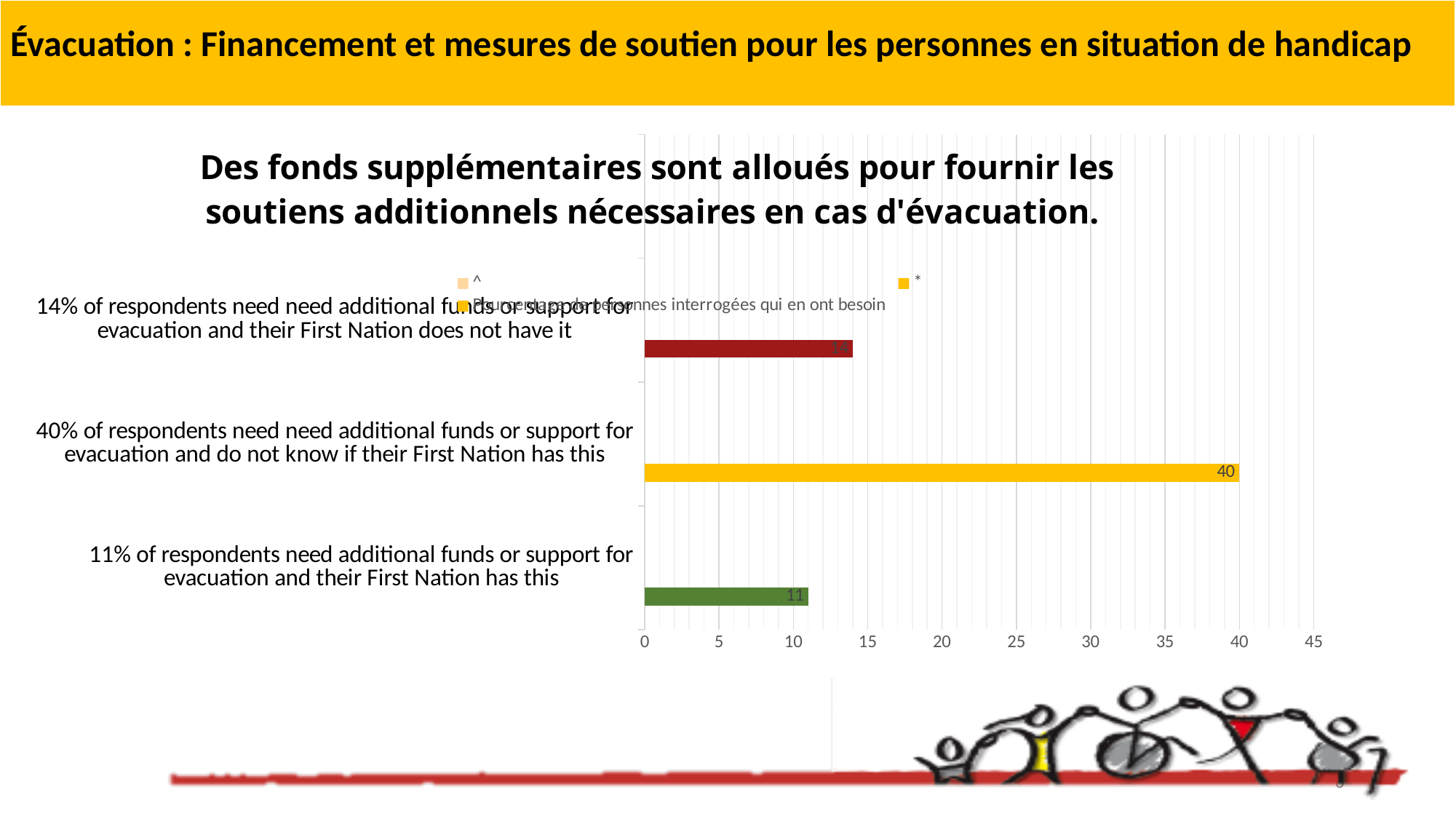
How many bars (categories) are plotted in the chart? 3 What is the difference between the value for respondents whose First Nation does not have it and the value for respondents whose First Nation has this? 3 Is the value for respondents who do not know if their First Nation has this greater or less than 35? greater Which category has the highest value? 40% of respondents need need additional funds or support for evacuation and do not know if their First Nation has this What is the value for the category '11% of respondents need additional funds or support for evacuation and their First Nation has this'? 11 What type of chart is shown on the slide? bar chart What is the title of the chart? Des fonds supplémentaires sont alloués pour fournir les soutiens additionnels nécessaires en cas d'évacuation. What is the value for the category '40% of respondents need need additional funds or support for evacuation and do not know if their First Nation has this'? 40 Which is larger: the value for respondents whose First Nation does not have it, or the value for respondents whose First Nation has this? respondents whose First Nation does not have it (14) What is the value for the category '14% of respondents need need additional funds or support for evacuation and their First Nation does not have it'? 14 Which category has the lowest value? 11% of respondents need additional funds or support for evacuation and their First Nation has this What is the difference between the value for respondents who do not know if their First Nation has this (40) and the value for respondents whose First Nation does not have it (14)? 26